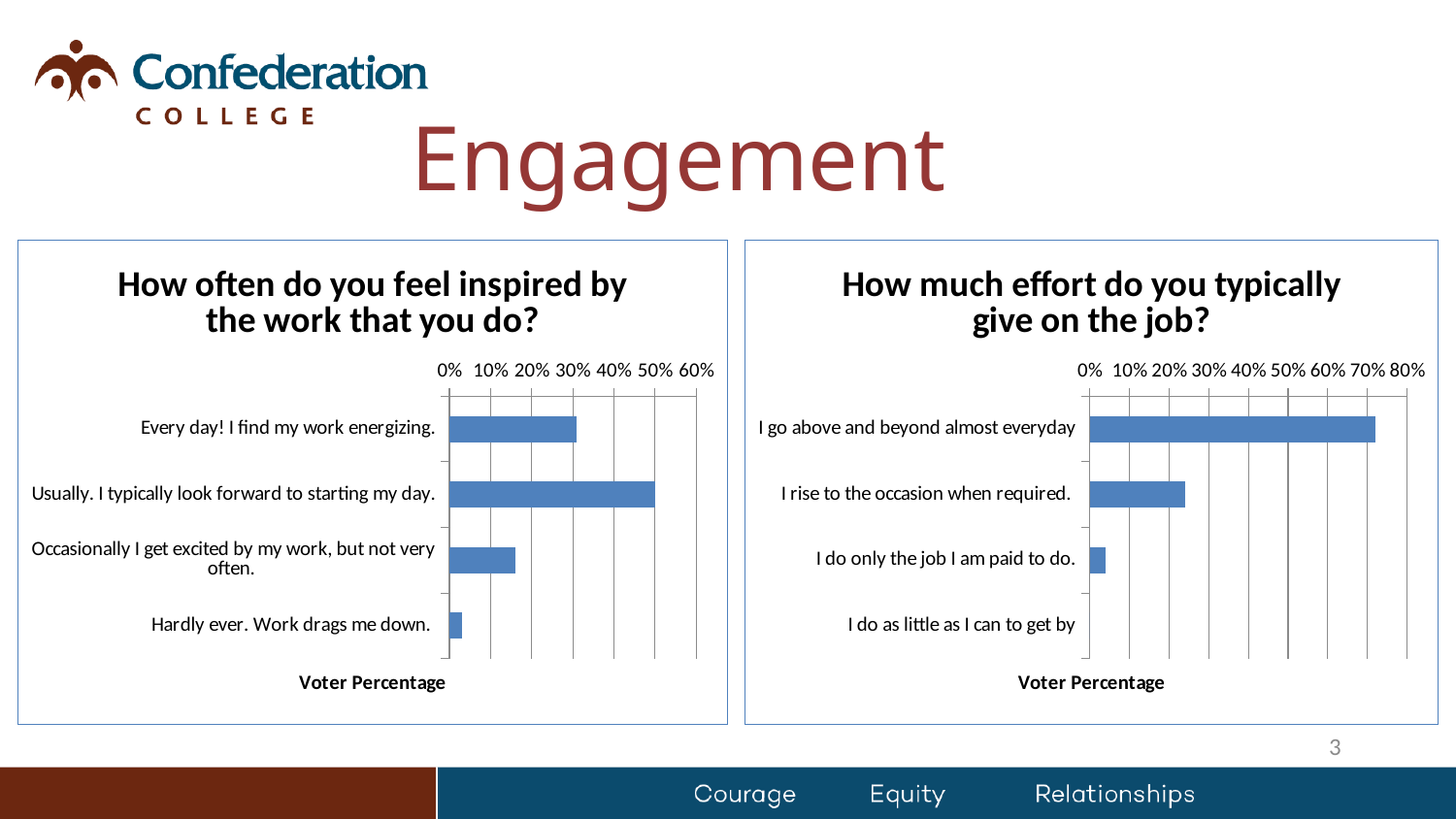
In the chart titled "How much effort do you typically give on the job?", which is larger: the value for "I rise to the occasion when required." or the value for "I do only the job I am paid to do."? I rise to the occasion when required. In the chart titled "How much effort do you typically give on the job?", which response has the lowest voter percentage? I do as little as I can to get by In the chart titled "How often do you feel inspired by the work that you do?", how many response categories are plotted? 4 In the chart titled "How much effort do you typically give on the job?", is the value for "I go above and beyond almost everyday" greater or less than 60%? greater In the chart titled "How often do you feel inspired by the work that you do?", is the value for "Every day! I find my work energizing." greater or less than 20%? greater In the chart titled "How often do you feel inspired by the work that you do?", which response has the lowest voter percentage? Hardly ever. Work drags me down. In the chart titled "How much effort do you typically give on the job?", how many response categories are plotted? 4 What is the axis label shown beneath the bars in the chart titled "How much effort do you typically give on the job?"? Voter Percentage In the chart titled "How often do you feel inspired by the work that you do?", which response has the highest voter percentage? Usually. I typically look forward to starting my day. In the chart titled "How often do you feel inspired by the work that you do?", what kind of chart is shown? bar chart In the chart titled "How often do you feel inspired by the work that you do?", is the value for "Occasionally I get excited by my work, but not very often." greater or less than 20%? less In the chart titled "How much effort do you typically give on the job?", which response has the highest voter percentage? I go above and beyond almost everyday